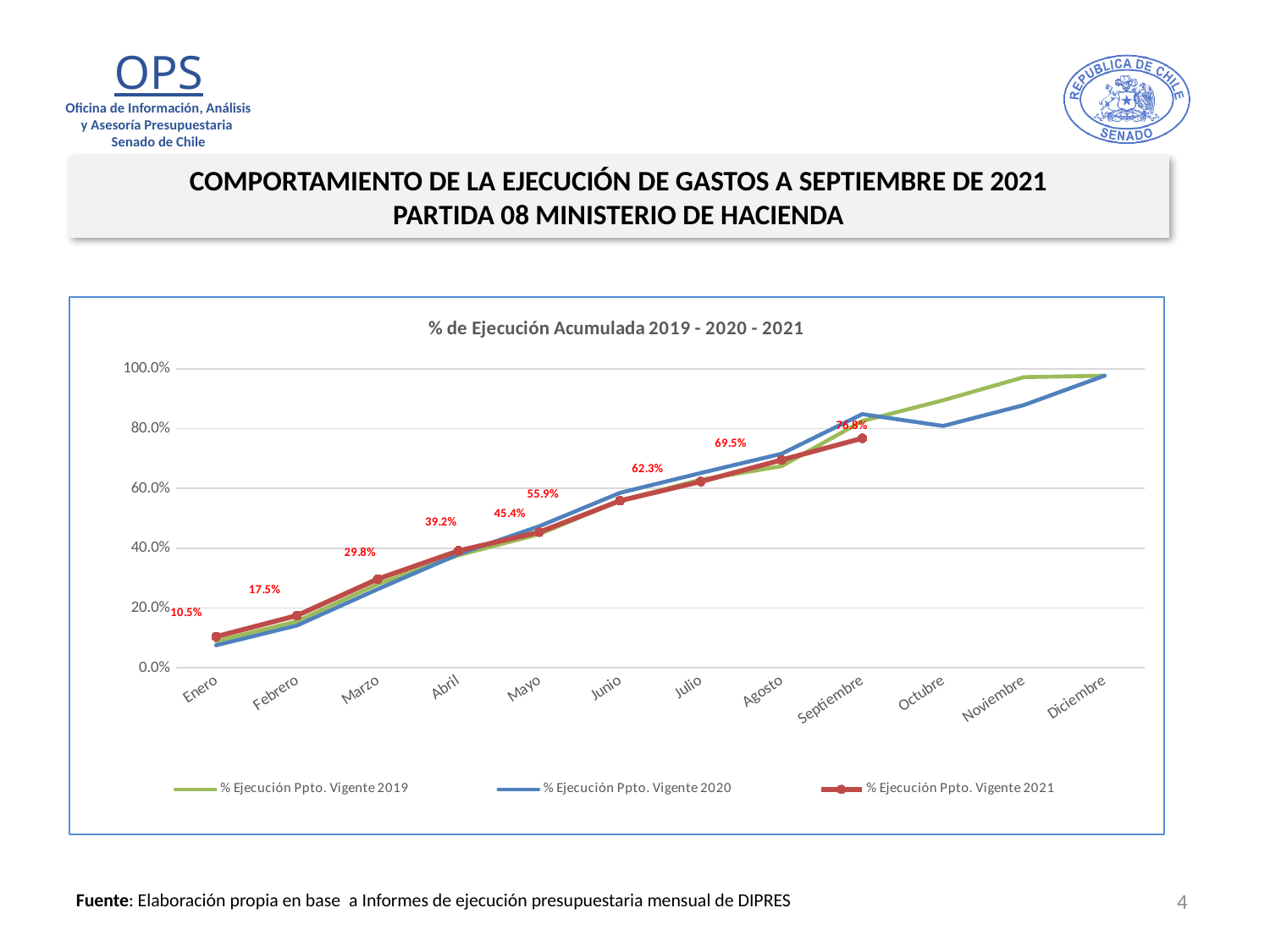
How many series does the chart legend list? 3 What is the % Ejecución Ppto. Vigente 2021 value for Mayo? 45.4% What is the difference between the 2021 values for Agosto and Enero? 59.0% In Noviembre, which series is higher: 2019 or 2020? % Ejecución Ppto. Vigente 2019 By how much does the 2021 series increase from Junio to Julio? 6.4% Does the % Ejecución Ppto. Vigente 2021 series rise or fall from Enero to Septiembre? rise What is the % Ejecución Ppto. Vigente 2021 value for Junio? 55.9% Is the % Ejecución Ppto. Vigente 2019 value for Noviembre greater or less than 80.0%? greater What kind of chart is shown on the slide? line chart How many months are shown on the x axis? 12 What is the % Ejecución Ppto. Vigente 2021 value for Enero? 10.5% What is the % Ejecución Ppto. Vigente 2021 value for Marzo? 29.8%